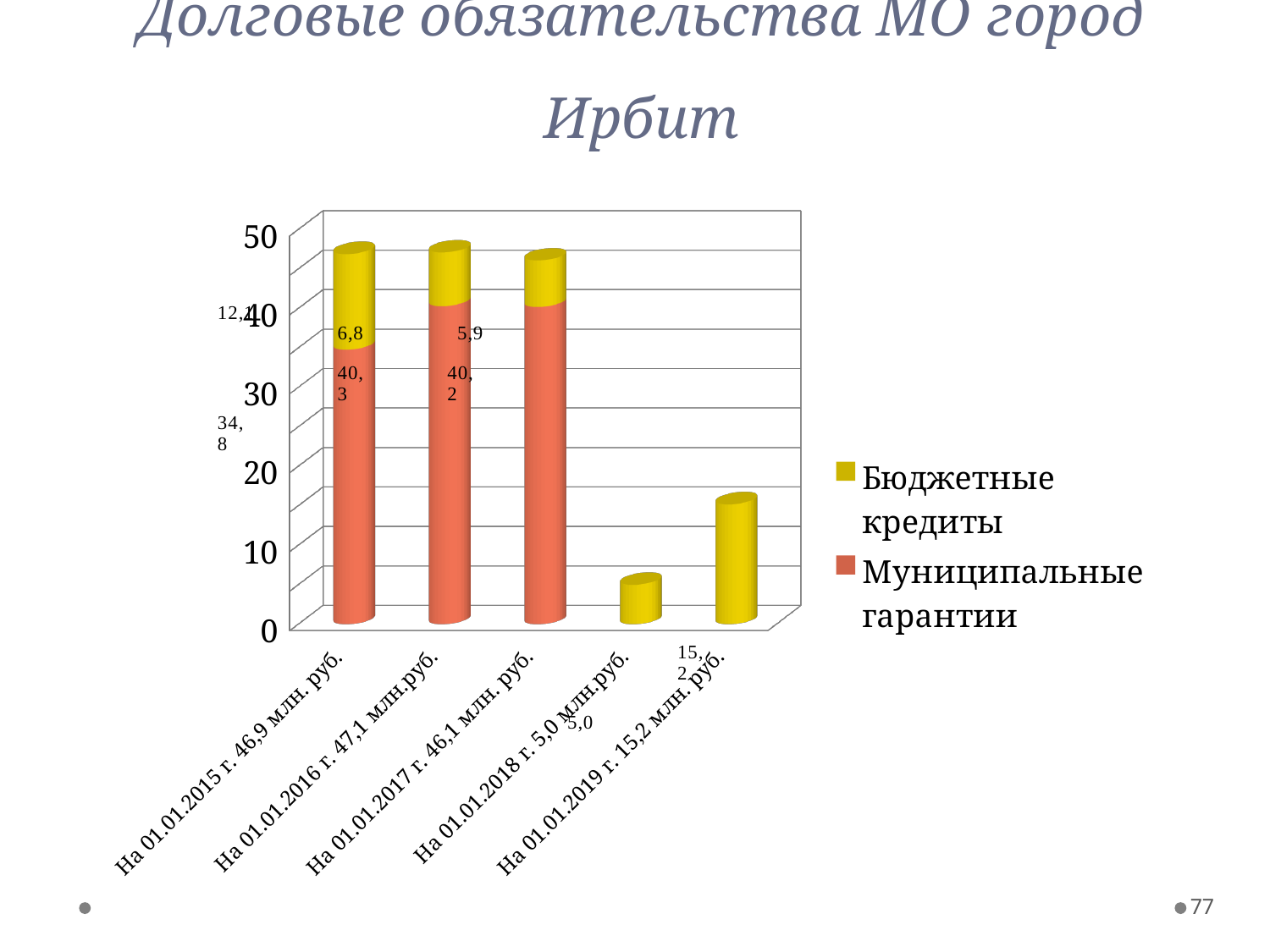
Which is larger: the total debt on 01.01.2019 or on 01.01.2018? 01.01.2019 What is the difference between the total debt on 01.01.2019 and on 01.01.2018? 10,2 млн. руб. What are the two series named in the legend? Бюджетные кредиты, Муниципальные гарантии On which date is the total debt the highest? 01.01.2016 On which date is the total debt the lowest? 01.01.2018 Is the bar for 01.01.2018 greater or less than 10? less How many dates (categories) are shown on the x axis? 5 What type of chart is shown on the slide? bar chart How many series does the legend list? 2 Does the total debt rise or fall from 01.01.2017 to 01.01.2018? fall What is the total debt shown for 01.01.2019? 15,2 млн. руб. What is the total debt shown for 01.01.2018? 5,0 млн.руб.